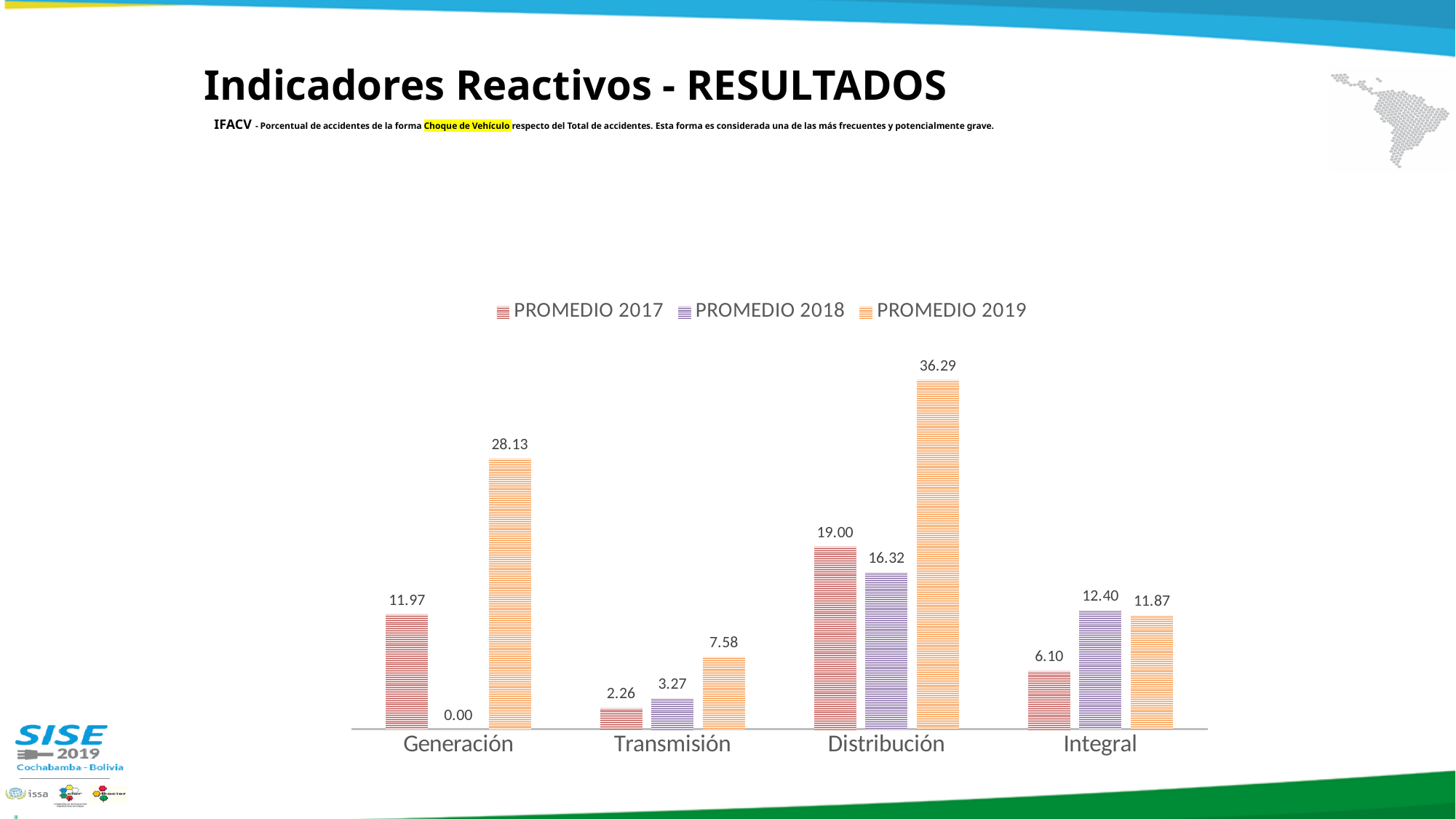
What kind of chart is shown on the slide? Bar chart What is the PROMEDIO 2017 value for Generación? 11.97 What is the difference between the PROMEDIO 2019 and PROMEDIO 2017 values for Generación? 16.16 Which is larger for Distribución, the PROMEDIO 2017 value or the PROMEDIO 2018 value? PROMEDIO 2017 How many series does the legend list? 3 Which category has the highest PROMEDIO 2019 value? Distribución What is the PROMEDIO 2018 value for Generación? 0.00 Which category has the lowest PROMEDIO 2017 value? Transmisión What are the three series named in the legend? PROMEDIO 2017, PROMEDIO 2018, PROMEDIO 2019 What is the PROMEDIO 2018 value for Integral? 12.40 What is the PROMEDIO 2019 value for Distribución? 36.29 How many categories are shown on the x axis? 4